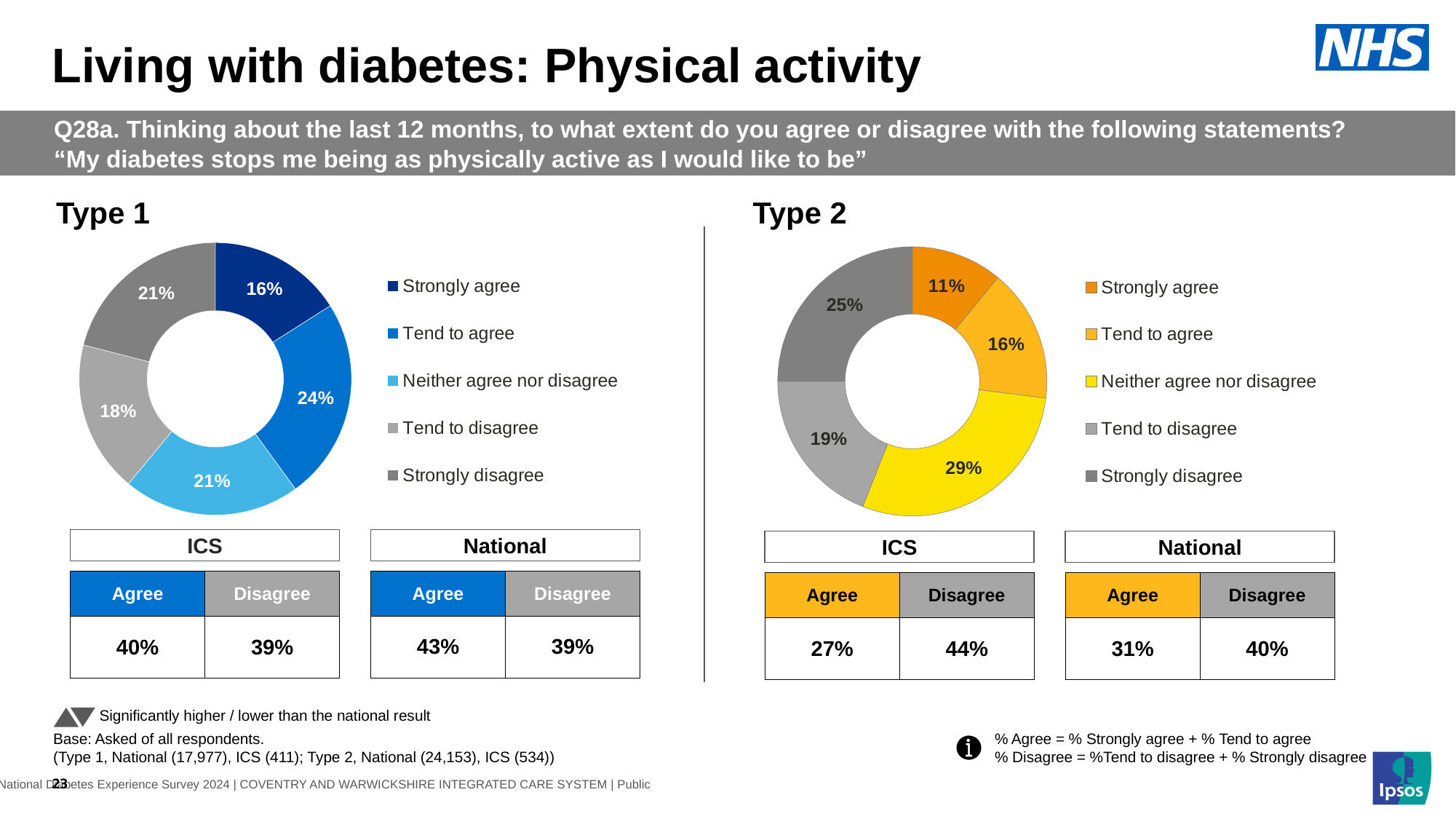
In the Type 2 chart, which response category has the smallest share? Strongly agree How many response categories does the legend of the Type 1 chart list? 5 In the Type 2 chart, what colour is the Neither agree nor disagree segment? Yellow In the Type 1 chart, what is the difference between the Tend to agree and Tend to disagree shares? 6 percentage points In the Type 2 chart, what percentage strongly agree? 11% In the Type 2 chart, what percentage of respondents said they neither agree nor disagree? 29% What kind of chart is used for the Type 2 results? Doughnut (pie) chart In the Type 1 chart, what percentage of respondents said they tend to agree? 24% In the Type 1 chart, what percentage strongly disagree? 21% In the Type 2 chart, which response category has the largest share? Neither agree nor disagree In the Type 2 chart, which is larger: the Strongly disagree share or the Tend to disagree share? Strongly disagree In the Type 1 chart, which response category has the smallest share? Strongly agree